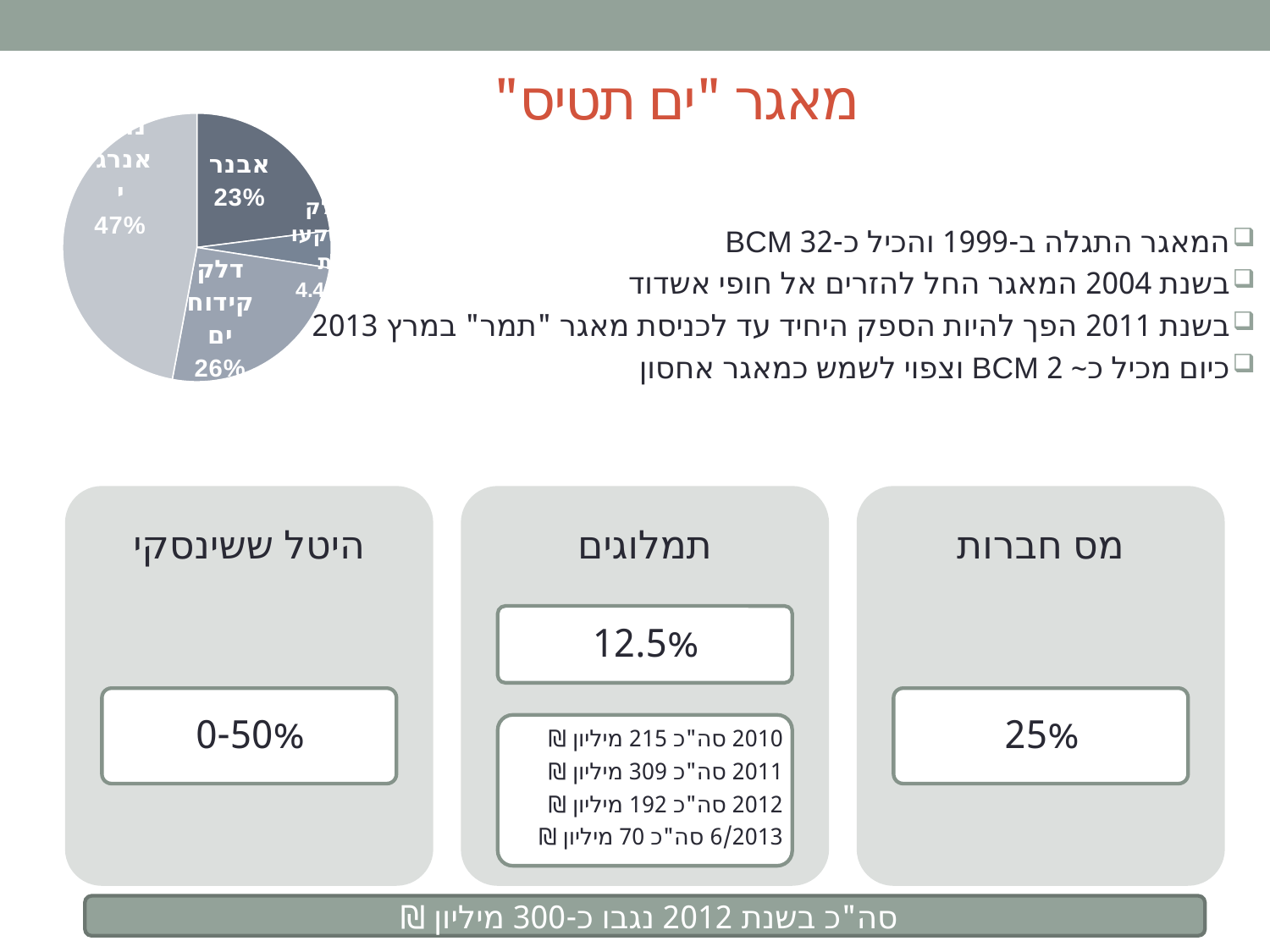
What is the percentage shown on the largest slice of the pie chart? 47% What kind of chart is shown on the slide? pie chart What share of the pie does the אבנר slice represent? 23% What percentage does the דלק קידוחים slice of the pie chart show? 26% How many slices does the pie chart have? 4 Which slice is larger in the pie chart, אבנר or דלק קידוחים? דלק קידוחים Which labelled slice of the pie chart is drawn in the darkest grey? אבנר Is the largest slice of the pie chart greater or less than 50%? less What is the difference in percentage points between the דלק קידוחים slice and the אבנר slice? 3% What percentage does the אבנר slice of the pie chart show? 23%